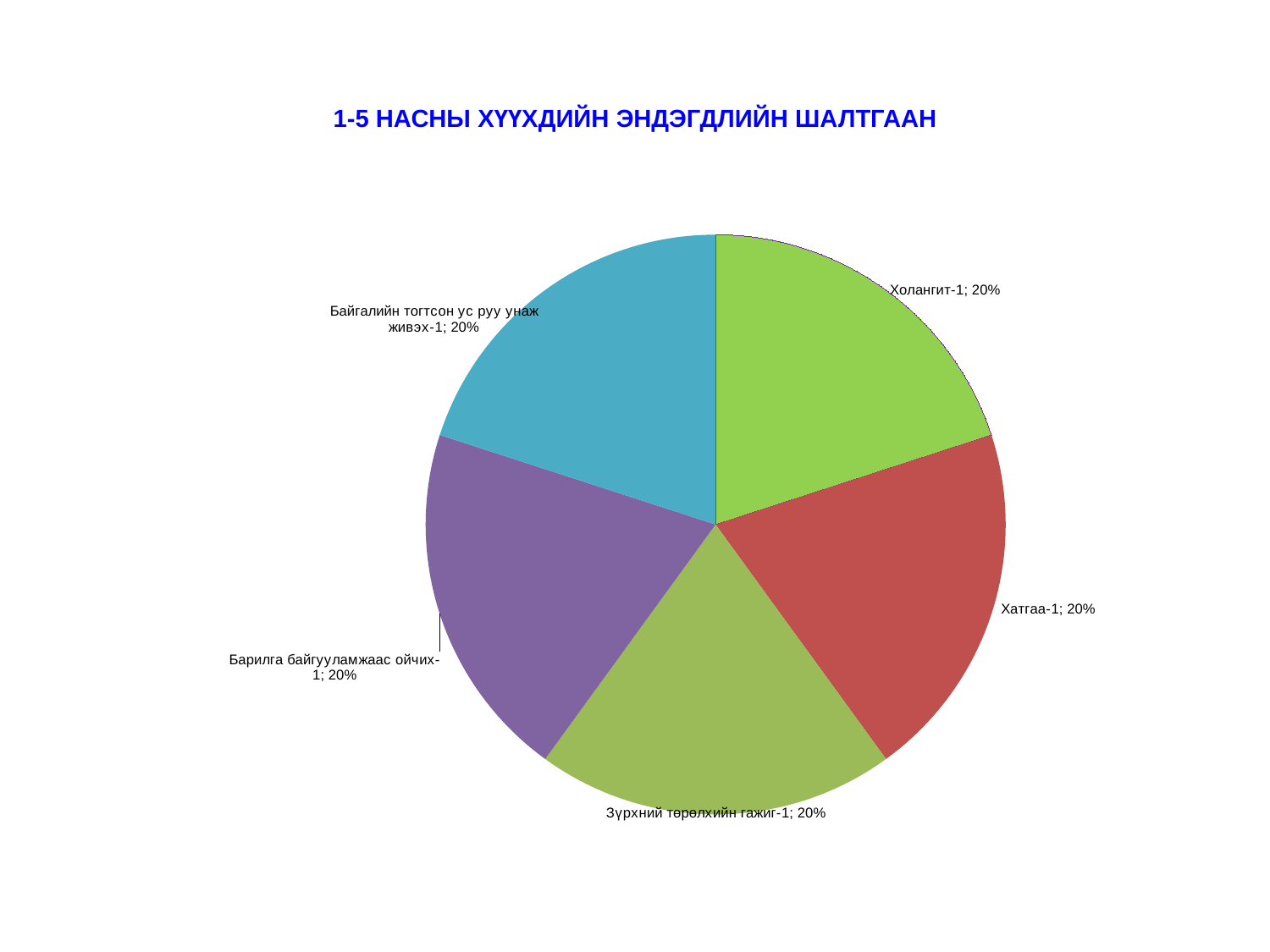
What share of the pie does the Барилга байгууламжаас ойчих slice represent? 20% What kind of chart is shown on the slide? Pie chart What share of the pie does the Холангит slice represent? 20% How many slices does the pie chart have? 5 What share of the pie does the Зүрхний төрөлхийн гажиг slice represent? 20% What is the value shown for Хатгаа? 20% What is the total of the values across all five slices? 100% What colour is the Хатгаа slice? Red What is the value shown for Холангит? 20% What is the title of the chart? 1-5 НАСНЫ ХҮҮХДИЙН ЭНДЭГДЛИЙН ШАЛТГААН